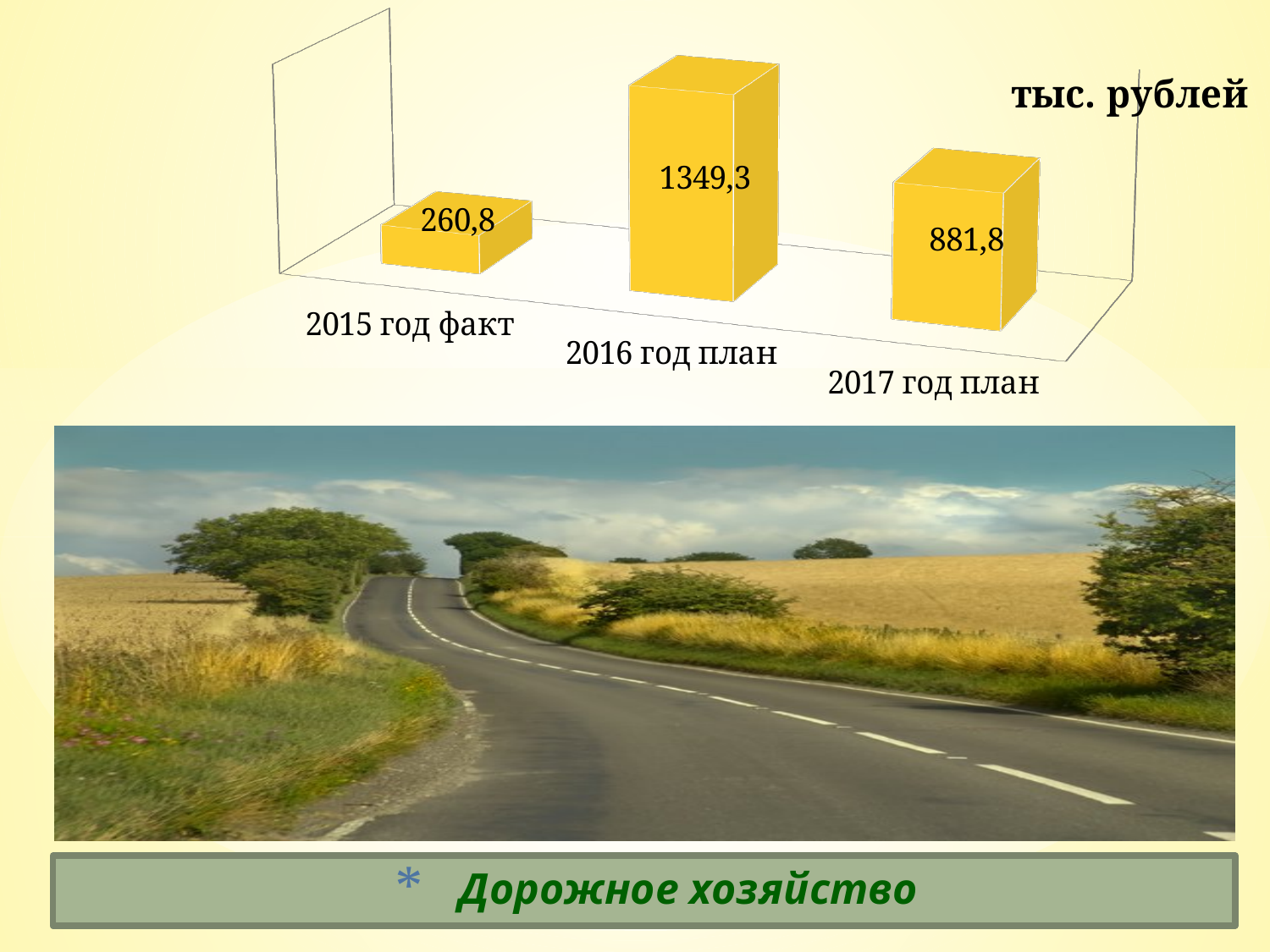
How many categories are shown in the chart? 3 Which category has the lowest value? 2015 год факт Which category has the highest value? 2016 год план What unit is indicated for the chart values? тыс. рублей Which is larger, the value for 2017 год план or the value for 2015 год факт? 2017 год план What kind of chart is shown on the slide? Bar chart What is the difference between the values for 2016 год план and 2015 год факт? 1088,5 What is the value for 2017 год план? 881,8 Do the values rise or fall from 2016 год план to 2017 год план? Fall What is the difference between the values for 2016 год план and 2017 год план? 467,5 What is the value for 2016 год план? 1349,3 What is the value for 2015 год факт? 260,8